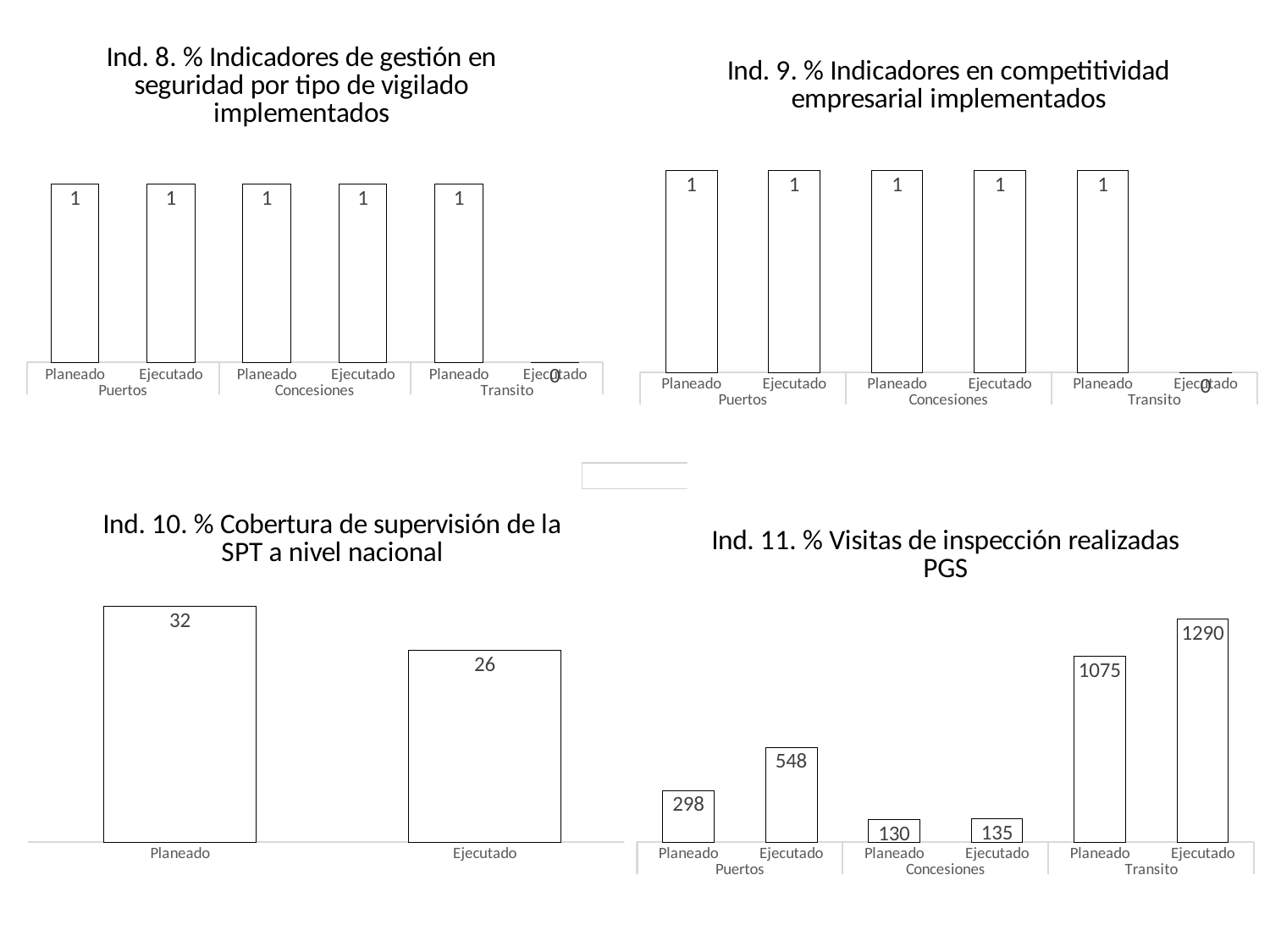
In the chart 'Ind. 11. % Visitas de inspección realizadas PGS', what is the value for Planeado under Puertos? 298 In the chart 'Ind. 8. % Indicadores de gestión en seguridad por tipo de vigilado implementados', what is the value for Ejecutado under Transito? 0 In the chart 'Ind. 11. % Visitas de inspección realizadas PGS', which is larger under Transito, Planeado or Ejecutado? Ejecutado In the chart 'Ind. 9. % Indicadores en competitividad empresarial implementados', what is the value for Planeado under Concesiones? 1 In the chart 'Ind. 10. % Cobertura de supervisión de la SPT a nivel nacional', what is the difference between Planeado and Ejecutado? 6 In the chart 'Ind. 10. % Cobertura de supervisión de la SPT a nivel nacional', what is the value for Planeado? 32 In the chart 'Ind. 11. % Visitas de inspección realizadas PGS', what is the value for Ejecutado under Transito? 1290 In the chart 'Ind. 11. % Visitas de inspección realizadas PGS', how many bars are plotted? 6 In the chart 'Ind. 10. % Cobertura de supervisión de la SPT a nivel nacional', which is larger, Planeado or Ejecutado? Planeado In the chart 'Ind. 11. % Visitas de inspección realizadas PGS', what is the difference between Ejecutado and Planeado under Puertos? 250 What type of chart is 'Ind. 10. % Cobertura de supervisión de la SPT a nivel nacional'? Bar chart In the chart 'Ind. 11. % Visitas de inspección realizadas PGS', which bar has the lowest value? Planeado (Concesiones)